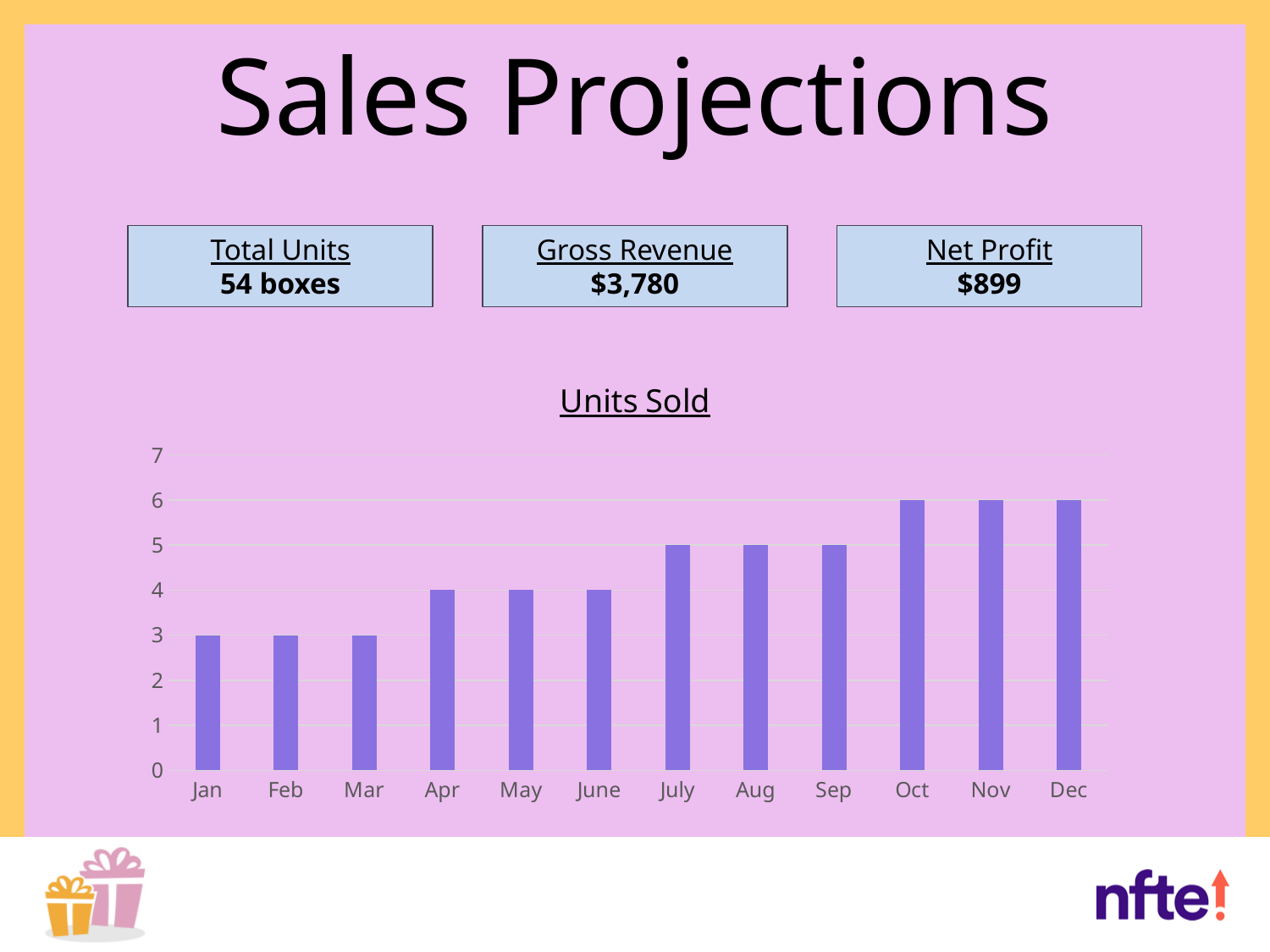
What is the value for Jan in the Units Sold chart? 3 What is the value for Apr in the Units Sold chart? 4 What is the value for Dec in the Units Sold chart? 6 What is the difference between the values for Oct and Apr in the Units Sold chart? 2 Do the values in the Units Sold chart generally rise or fall from Jan to Dec? rise Which has a larger value in the Units Sold chart, Feb or Aug? Aug What is the title of the chart on the slide? Units Sold What kind of chart is the Units Sold chart? bar chart How many months are shown on the x axis of the Units Sold chart? 12 Is the value for Nov in the Units Sold chart greater or less than 5? greater What is the value for July in the Units Sold chart? 5 What is the difference between the values for Dec and Jan in the Units Sold chart? 3